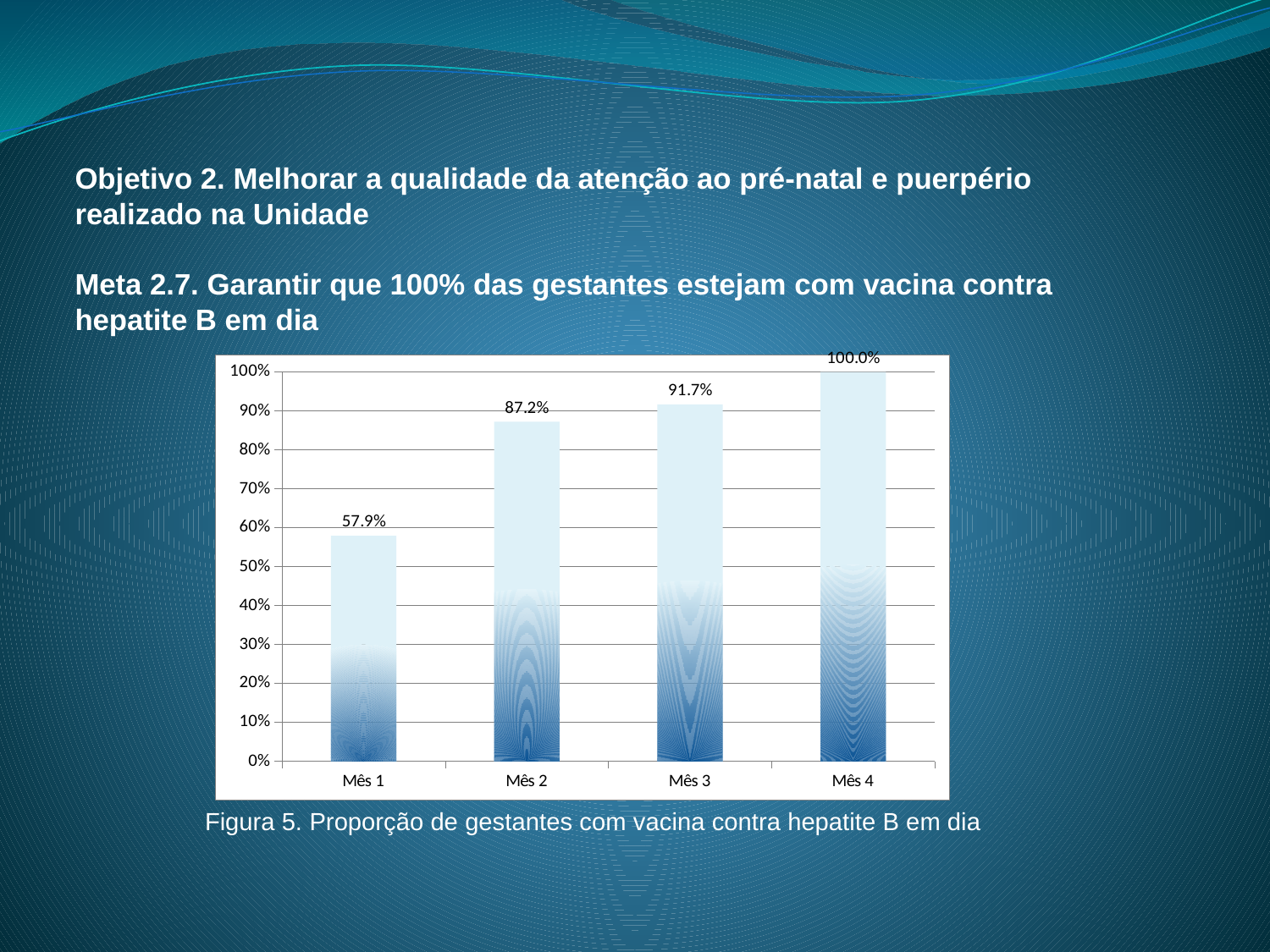
How many months are shown on the x axis? 4 What kind of chart is shown on the slide? Bar chart What is the value for Mês 4? 100.0% Which month has the highest value? Mês 4 Do the values rise or fall from Mês 1 to Mês 4? Rise What is the value for Mês 1? 57.9% What is the difference between the values for Mês 4 and Mês 3? 8.3% What is the value for Mês 2? 87.2% Which is larger, the value for Mês 2 or the value for Mês 3? Mês 3 What is the difference between the values for Mês 2 and Mês 1? 29.3% Which month has the lowest value? Mês 1 What is the value for Mês 3? 91.7%